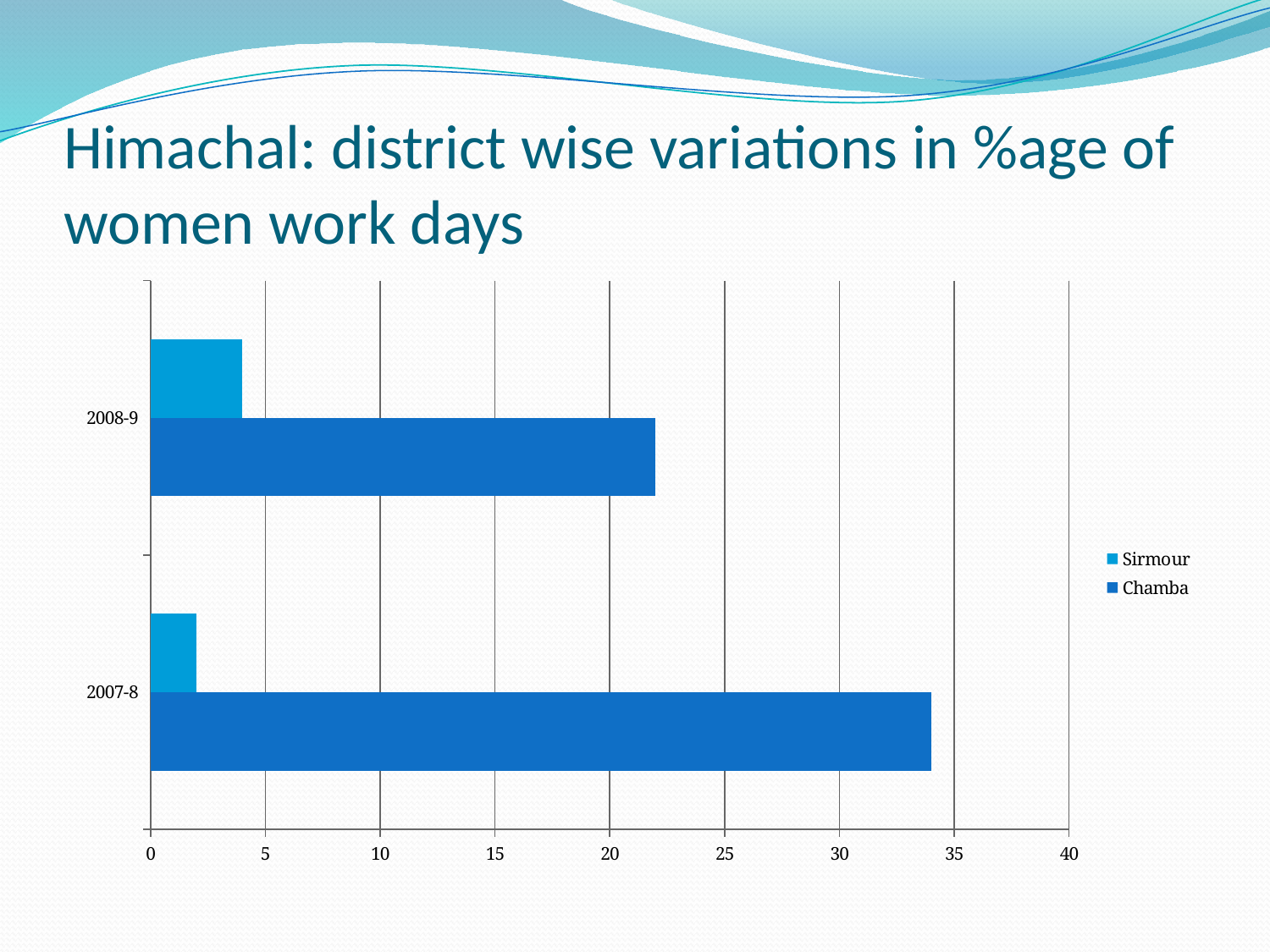
How many series does the legend list? 2 Is the value for Sirmour in 2008-9 greater or less than 5? less Does the value for Chamba rise or fall from 2007-8 to 2008-9? fall In 2007-8, which district has the larger value, Sirmour or Chamba? Chamba How many year categories are shown on the chart? 2 Is the value for Sirmour in 2007-8 greater or less than 5? less Is the value for Chamba in 2008-9 greater or less than 20? greater What kind of chart is shown on the slide? bar chart Does the value for Sirmour rise or fall from 2007-8 to 2008-9? rise For Chamba, which year has the higher value, 2007-8 or 2008-9? 2007-8 What is the maximum value shown on the horizontal axis? 40